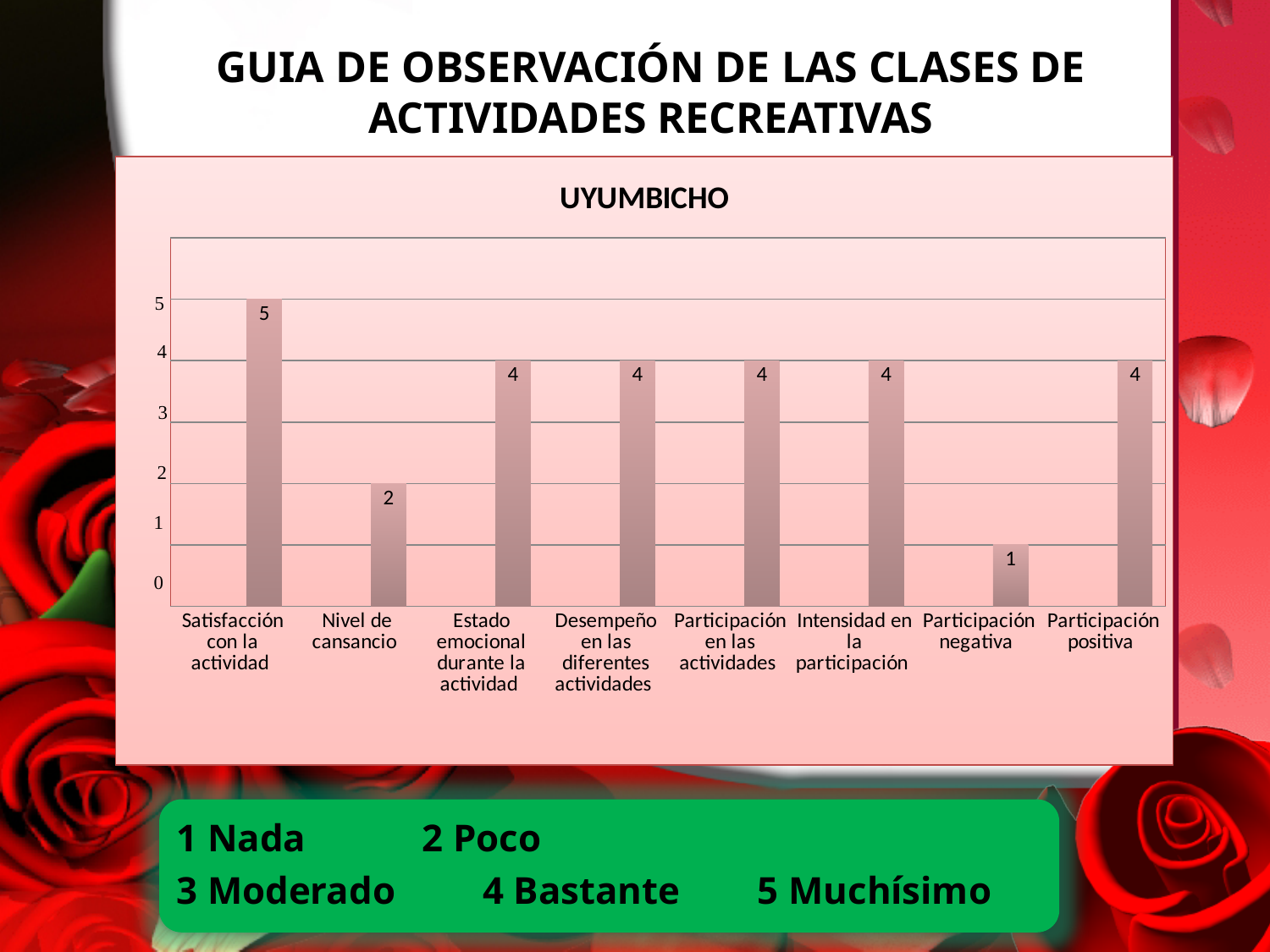
What kind of chart is shown? Bar chart What is the difference between the values for Satisfacción con la actividad and Nivel de cansancio? 3 Which is larger, the value for Participación positiva or the value for Participación negativa? Participación positiva What is the value for Satisfacción con la actividad? 5 What is the value for Nivel de cansancio? 2 Which category has the highest value? Satisfacción con la actividad How many categories have a value of 4? 5 What is the value for Participación negativa? 1 Which category has the lowest value? Participación negativa What is the title of the chart? UYUMBICHO How many categories are shown on the x axis? 8 What is the value for Intensidad en la participación? 4